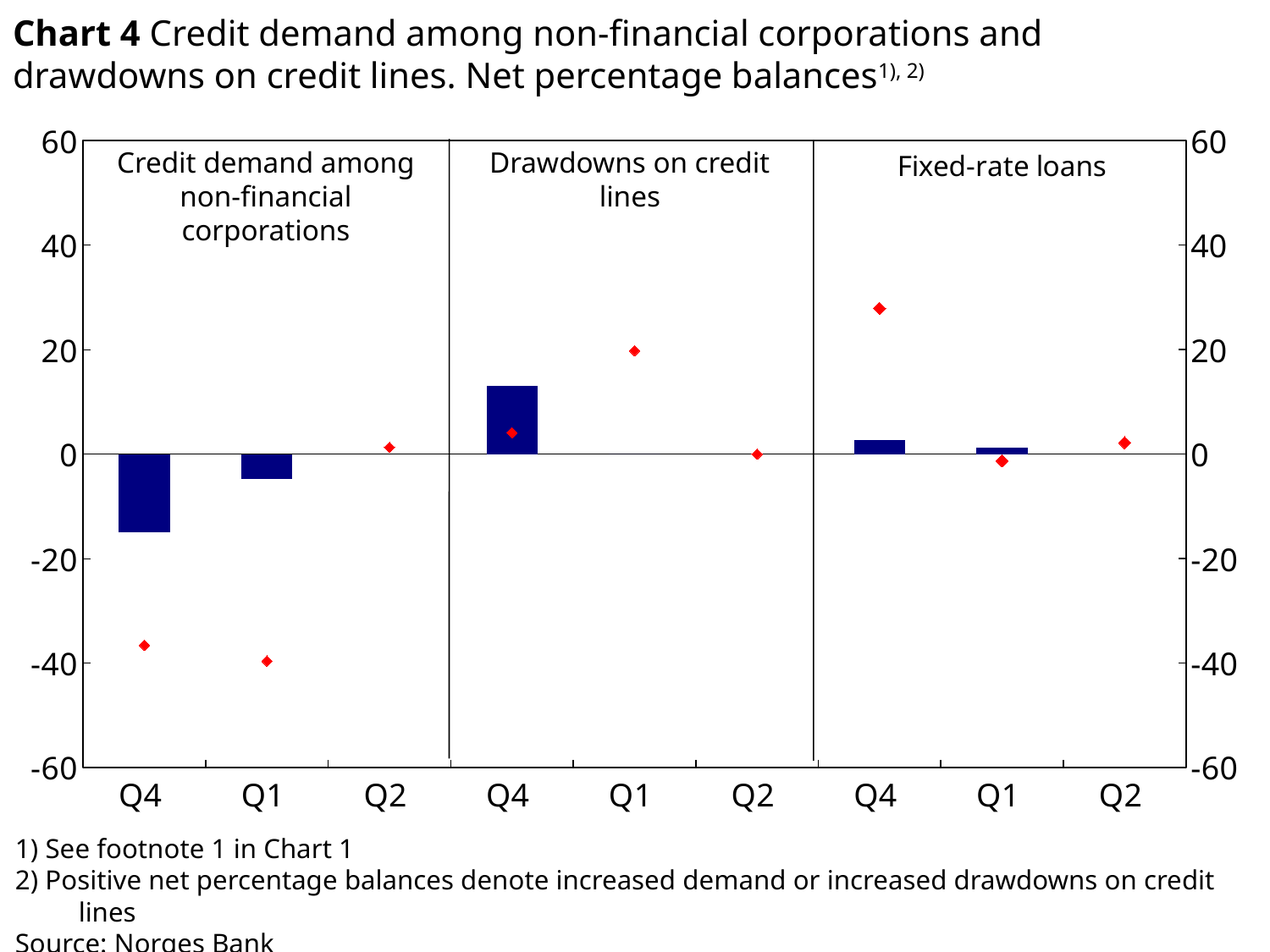
In the 'Credit demand among non-financial corporations' panel, is the bar for Q4 greater or less than -10? less How many panels does the chart have? 3 In the 'Credit demand among non-financial corporations' panel, is the red diamond for Q4 greater or less than -20? less In the 'Fixed-rate loans' panel, is the red diamond for Q4 greater or less than 20? greater In the 'Credit demand among non-financial corporations' panel, which quarter has the lower bar, Q4 or Q1? Q4 How many quarters are shown in each panel of the chart? 3 Which panel contains the tallest positive bar? Drawdowns on credit lines What are the minimum and maximum values shown on the vertical axis? -60 and 60 In the 'Drawdowns on credit lines' panel, which red diamond is higher, Q4 or Q1? Q1 What kind of chart is shown on the slide? bar chart